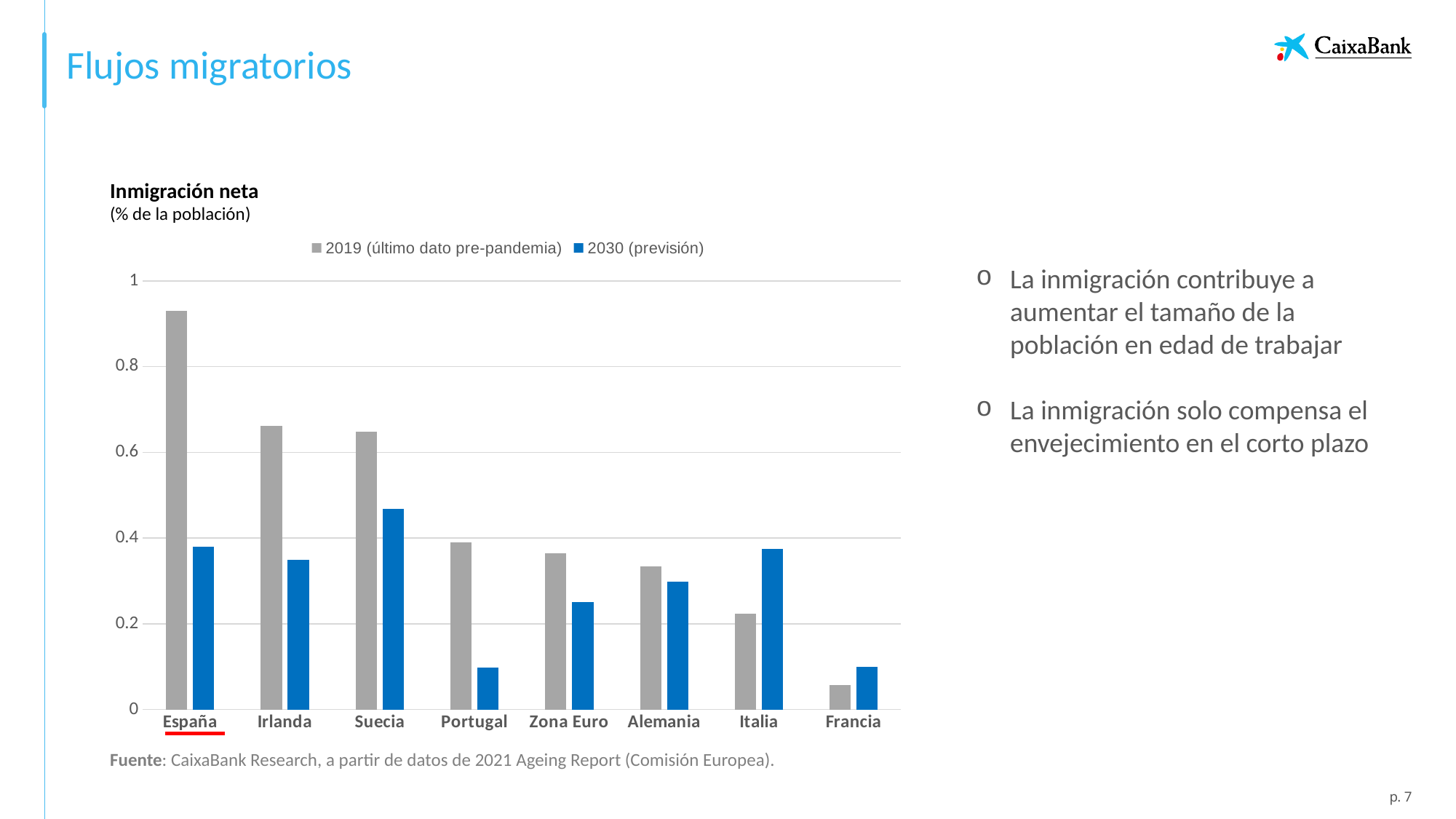
For Italia, which is larger: the 2019 value or the 2030 (previsión) value? 2030 (previsión) Which country has the highest value for 2030 (previsión)? Suecia How many countries or regions are shown on the x axis of the chart? 8 What is the title of the chart? Inmigración neta How many series does the chart legend list? 2 Is the 2030 (previsión) value for Portugal greater or less than 0.2? less Is the 2019 value for España greater or less than 0.8? greater What kind of chart is shown on the slide? Bar chart Which country has the highest value for 2019 (último dato pre-pandemia)? España Is the 2019 value for Irlanda greater or less than 0.6? greater For España, which is larger: the 2019 value or the 2030 (previsión) value? 2019 (último dato pre-pandemia) Which country has the lowest value for 2019 (último dato pre-pandemia)? Francia